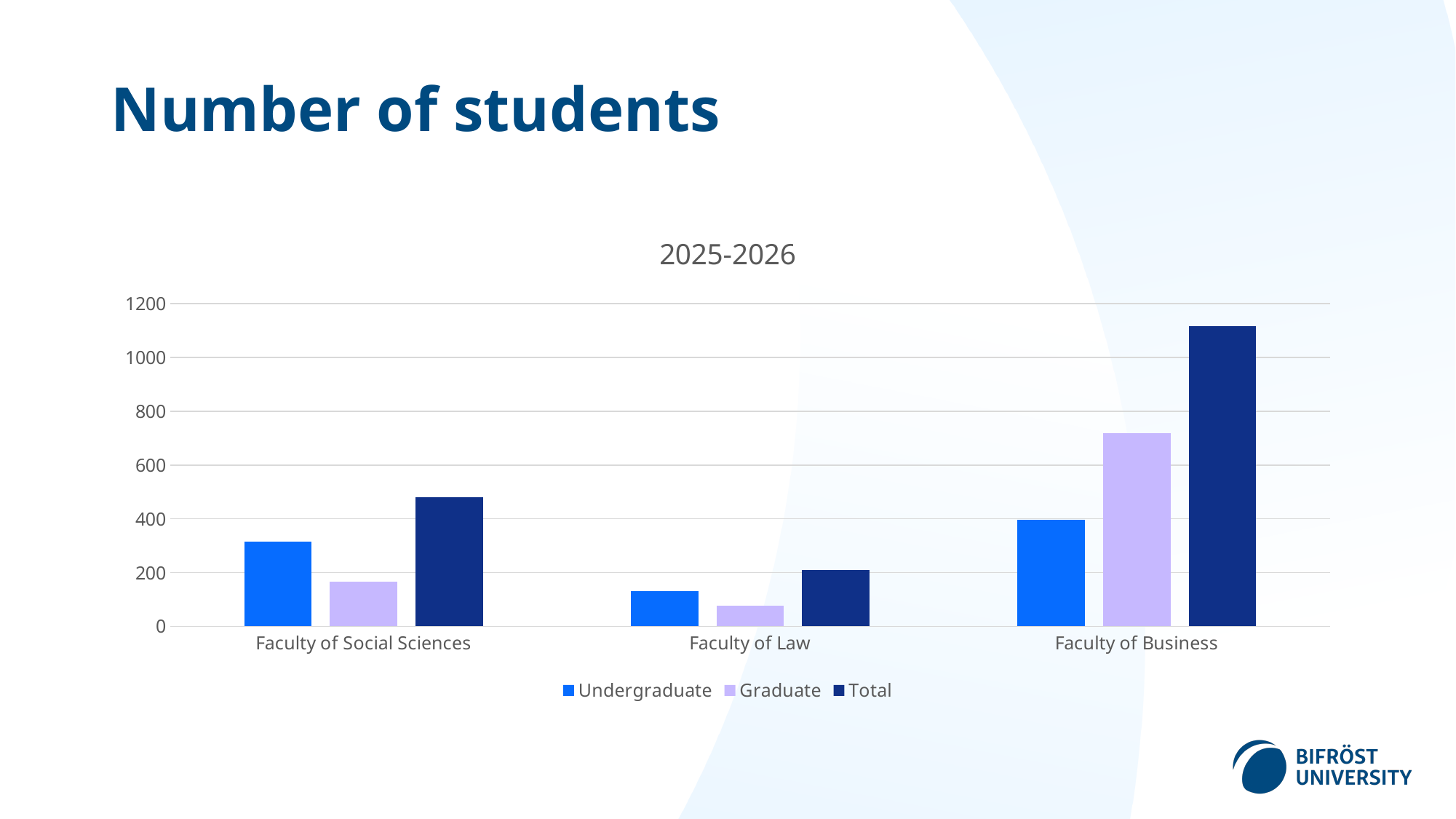
What is the title of the chart? 2025-2026 What kind of chart is shown on the slide? bar chart In the Faculty of Business, which is larger: Undergraduate or Graduate? Graduate Which faculty has the lowest Total number of students? Faculty of Law Is the Graduate value for Faculty of Law greater or less than 100? less Is the Total value for Faculty of Business greater or less than 1000? greater Is the Graduate value for Faculty of Business greater or less than 600? greater Which faculty has the highest Total number of students? Faculty of Business How many faculties are shown on the x axis? 3 Which faculty has the lowest Graduate number of students? Faculty of Law How many series does the legend list? 3 In the Faculty of Social Sciences, which is larger: Undergraduate or Graduate? Undergraduate